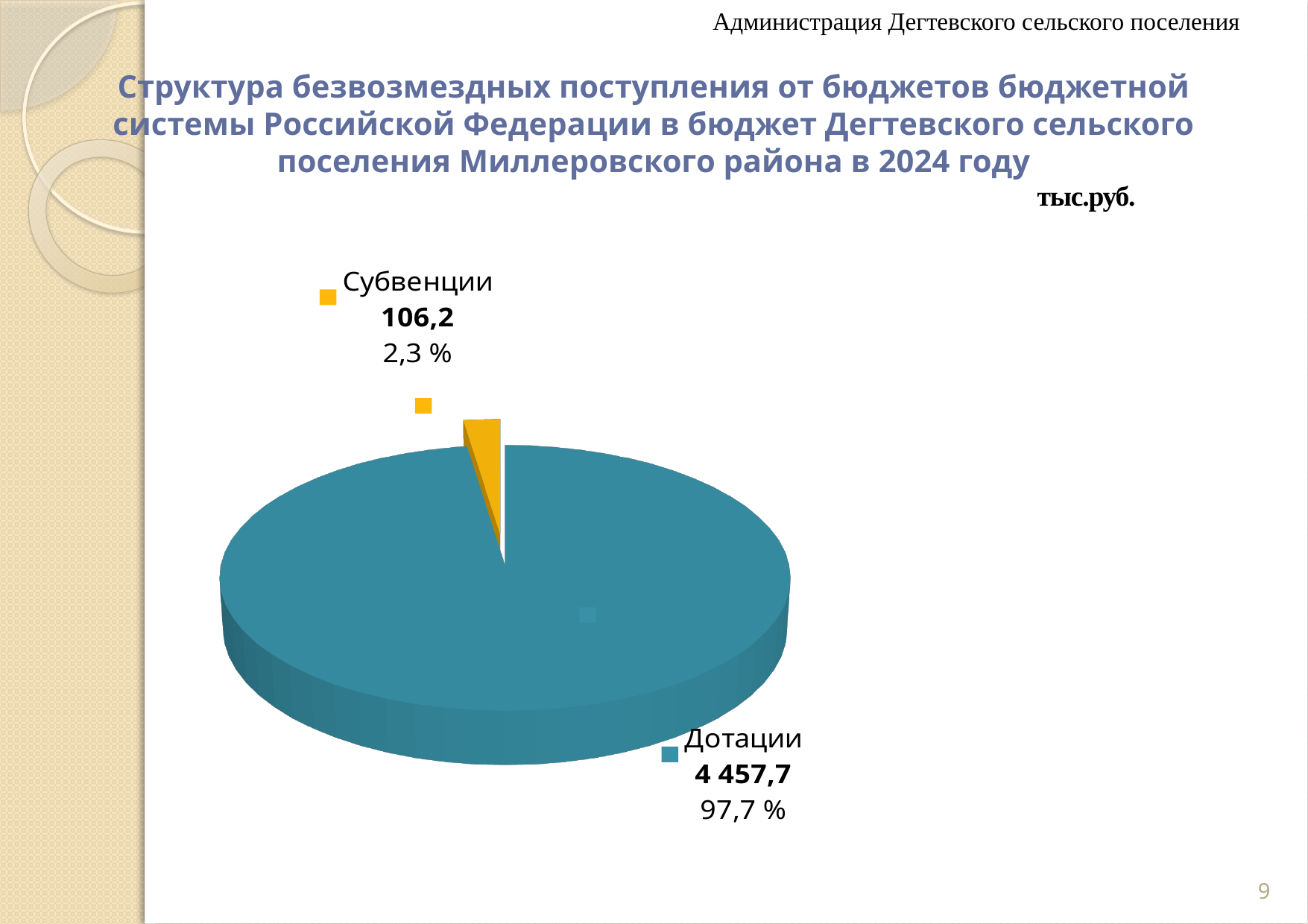
What share of the pie does Субвенции take? 2,3 % Which category has the largest slice? Дотации What is the value for Субвенции? 106,2 What is the difference between the values for Дотации and Субвенции? 4 351,5 Which is larger, Дотации or Субвенции? Дотации What colour is the slice for Субвенции? yellow What kind of chart is shown on the slide? pie chart What share of the pie does Дотации take? 97,7 % What is the value for Дотации? 4 457,7 Which category has the smallest slice? Субвенции What is the total of the two values shown in the chart? 4 563,9 How many categories are shown in the pie chart? 2